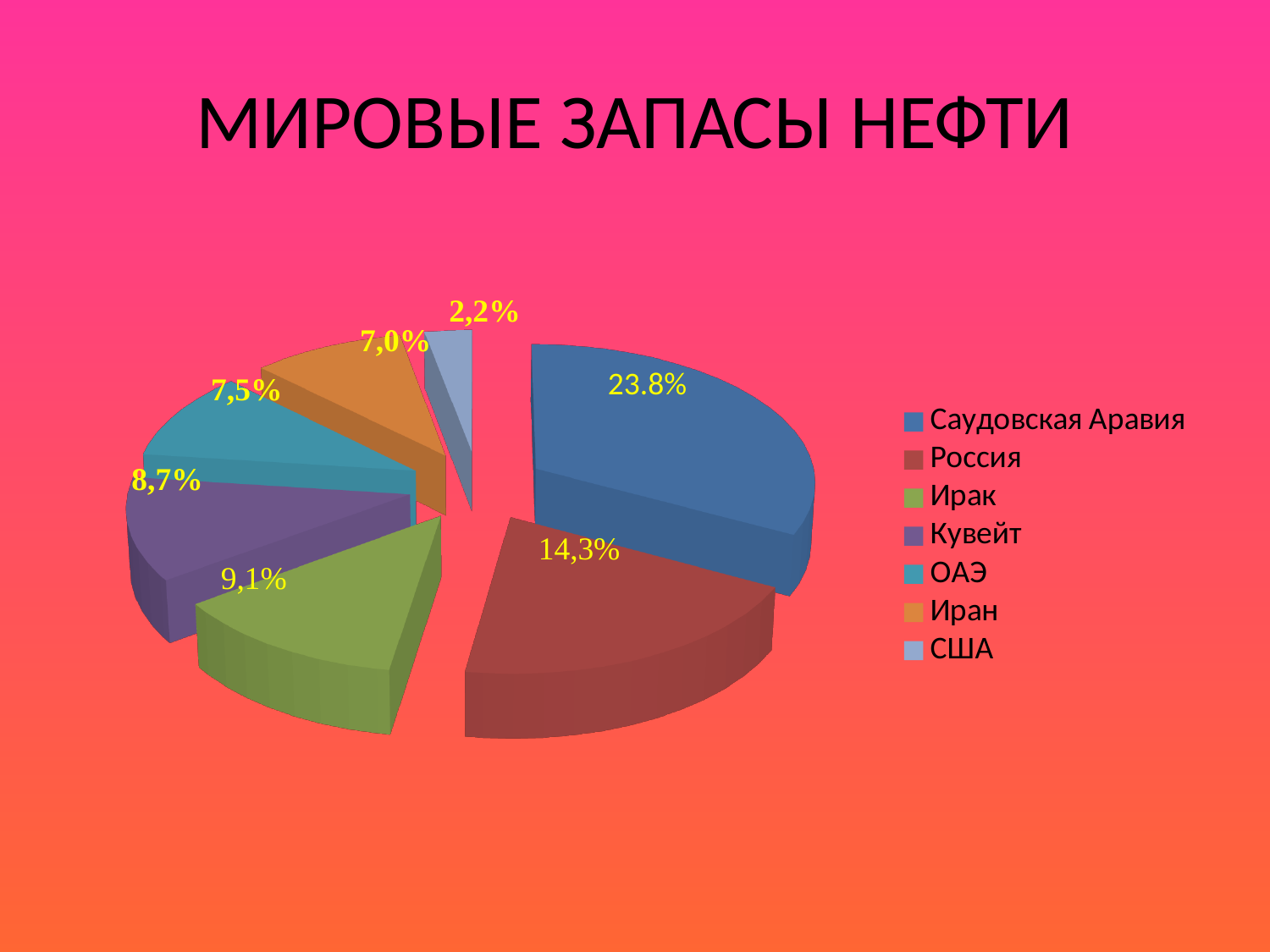
What share of the pie does Саудовская Аравия have? 23.8% How many slices does the pie chart have? 7 What is the value shown for США? 2,2% Which country is listed last in the legend? США What is the value shown for Россия? 14,3% What is the value shown for Ирак? 9,1% What is the difference between the values for Россия and Ирак? 5,2% What is the title of the chart? МИРОВЫЕ ЗАПАСЫ НЕФТИ Which is larger, the value for Кувейт or the value for ОАЭ? Кувейт What kind of chart is shown on the slide? pie chart Which country has the smallest slice of the pie? США Which country has the largest slice of the pie? Саудовская Аравия